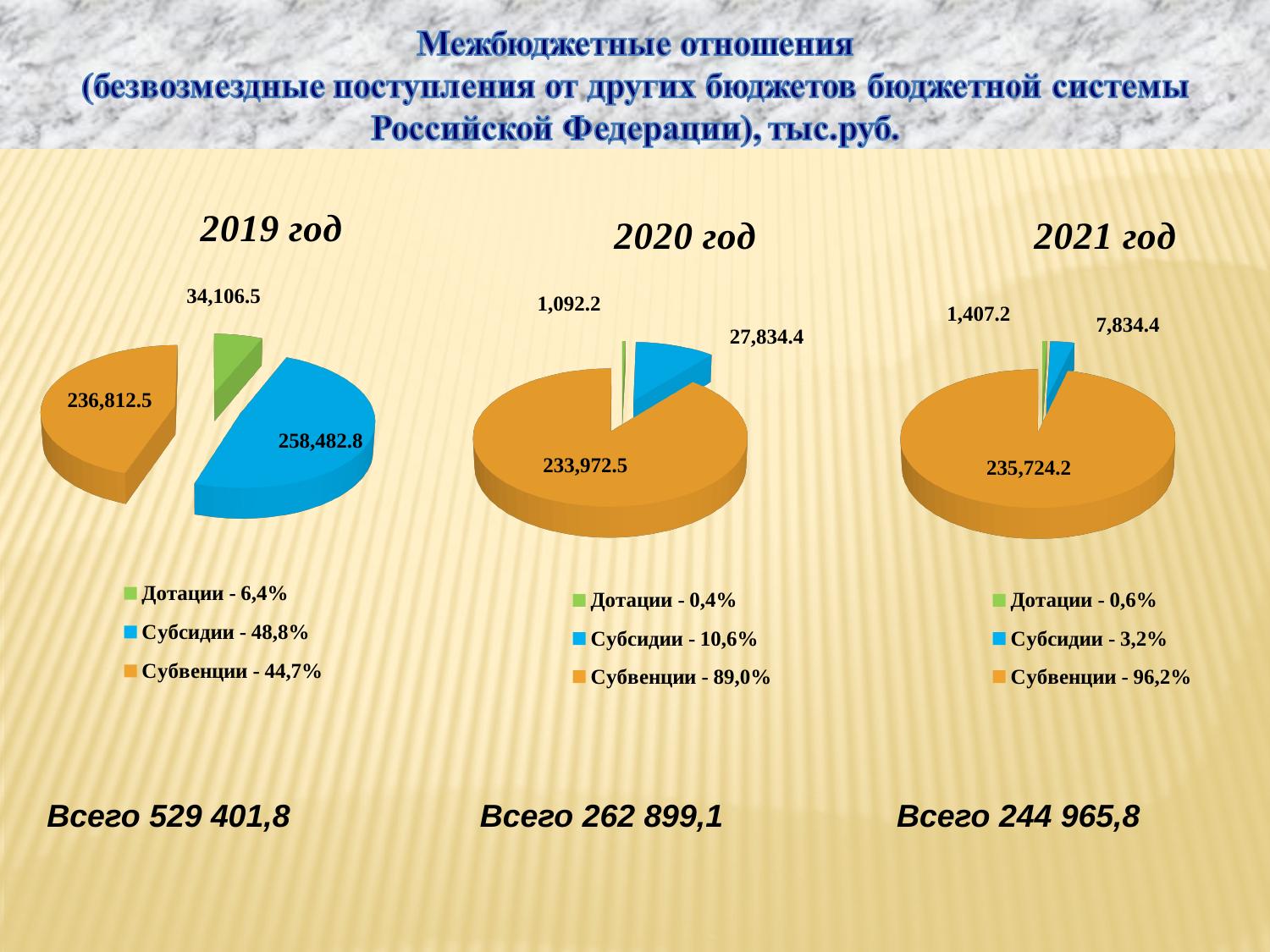
In the 2019 год chart, what is the value for Субсидии? 258,482.8 In the 2021 год chart, what is the value for Дотации? 1,407.2 In the 2020 год chart, what is the value for Субвенции? 233,972.5 What kind of chart is used for the 2020 год data? Pie chart In the 2021 год chart, which category has the largest value? Субвенции In the 2020 год chart, what share of the pie does Субвенции represent according to the legend? 89,0% In the 2019 год chart, what is the difference between the values for Субсидии and Субвенции? 21,670.3 In the 2019 год chart, which category has the smallest value? Дотации What total (Всего) is shown below the 2019 год chart? 529 401,8 In the 2020 год chart, which is larger: Субсидии or Дотации? Субсидии How many slices does the 2021 год pie chart have? 3 In the 2021 год chart, what share of the pie does Субсидии represent according to the legend? 3,2%